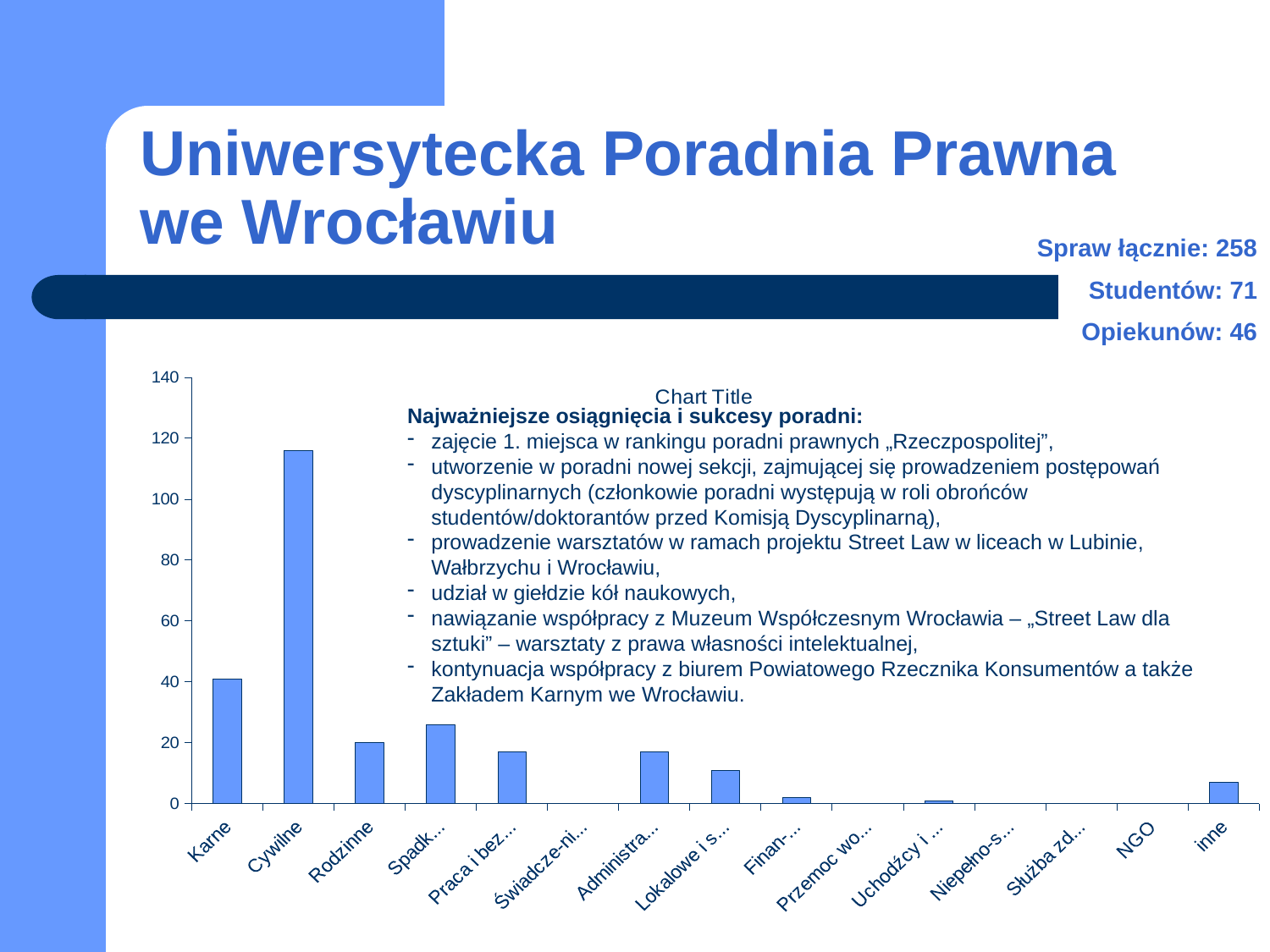
Which is larger, the value for Karne or the value for Rodzinne? Karne What is the highest value shown on the chart's vertical axis? 140 Is the value for Karne greater or less than 20? greater Which is larger, the value for Cywilne or the value for Karne? Cywilne How many categories are shown on the x axis of the chart? 15 Is the value for inne greater or less than 20? less Which category has the highest bar in the chart? Cywilne What is the title shown on the chart? Chart Title Is the value for Cywilne greater or less than 100? greater What kind of chart is shown on the slide? bar chart